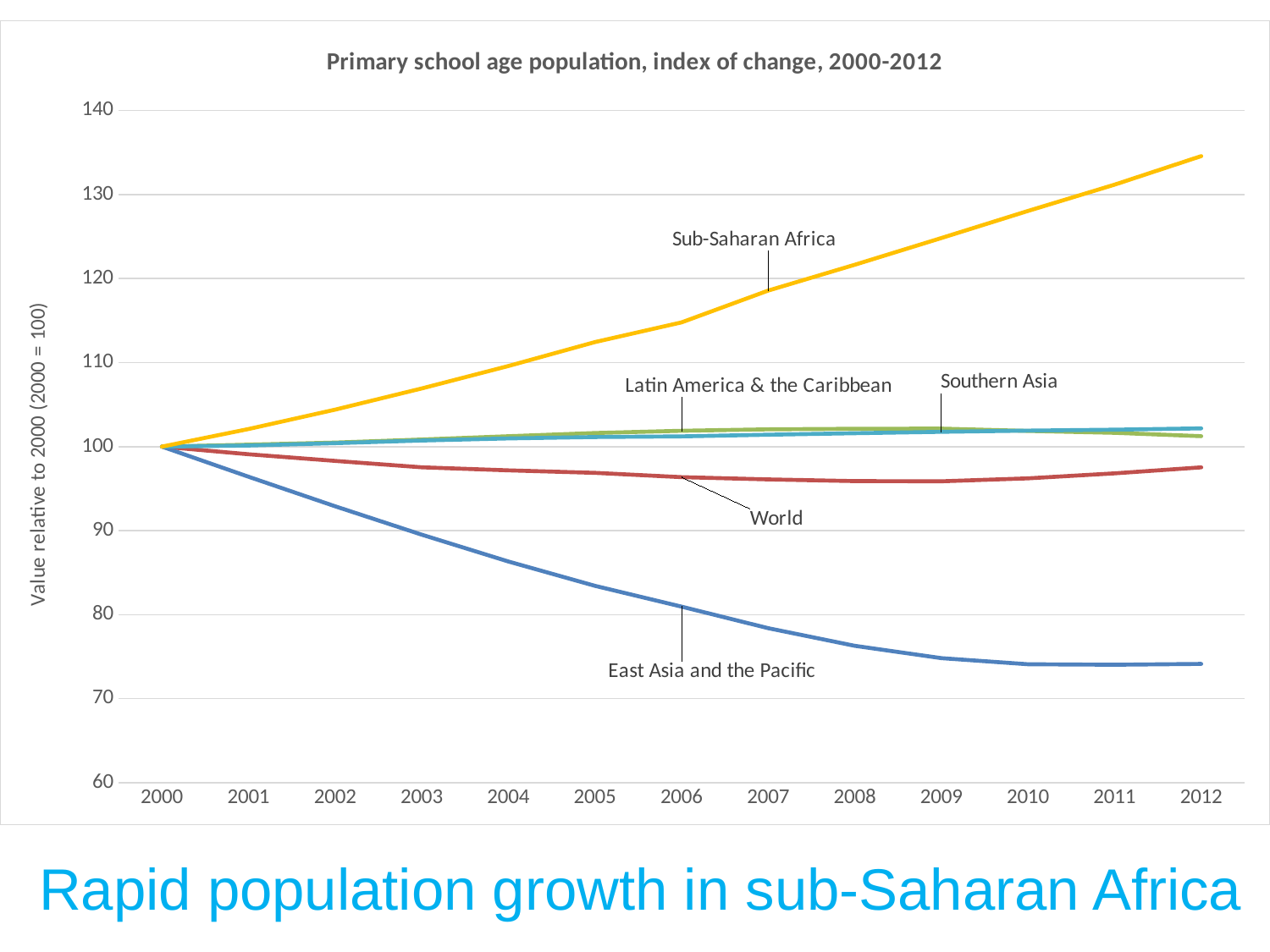
Does the Sub-Saharan Africa line rise or fall from 2000 to 2012? rise What kind of chart is shown on the slide? line chart Which series has the highest value in 2012? Sub-Saharan Africa Which series has the lowest value in 2012? East Asia and the Pacific How many series (lines) are plotted on the chart? 5 Is the value for East Asia and the Pacific in 2012 greater or less than 80? less Does the East Asia and the Pacific line rise or fall from 2000 to 2012? fall Is the value for Sub-Saharan Africa in 2012 greater or less than 130? greater What is the value for Sub-Saharan Africa in 2000? 100 How many years are shown along the x axis? 13 In 2012, which is larger: the value for World or the value for Sub-Saharan Africa? Sub-Saharan Africa What is the title of the chart? Primary school age population, index of change, 2000-2012